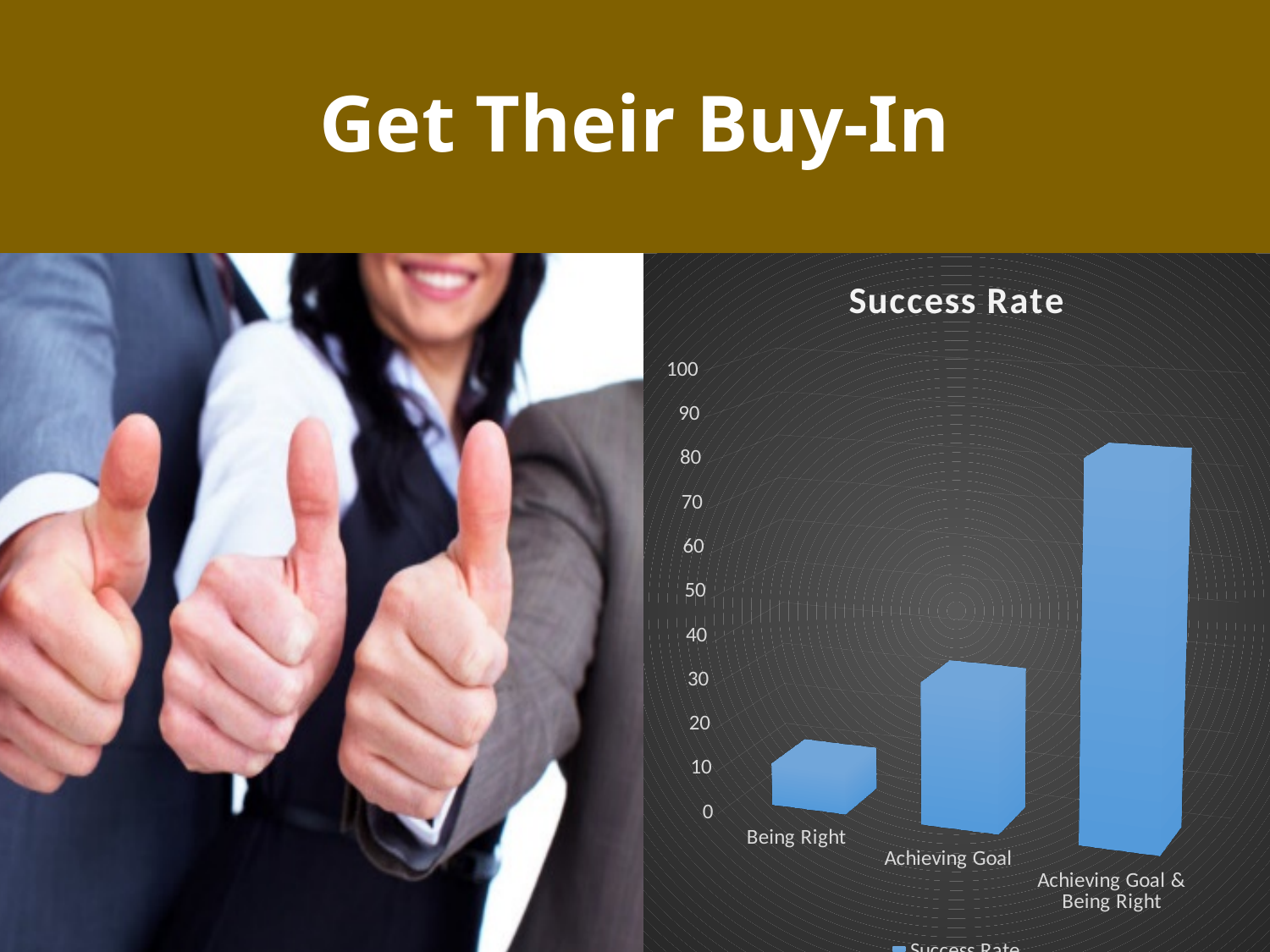
Is the value for Achieving Goal & Being Right greater or less than 60? greater Is the value for Achieving Goal greater or less than 20? greater Is the value for Achieving Goal & Being Right greater or less than 90? less Which category has the highest value in the chart? Achieving Goal & Being Right Which category has the lowest value in the chart? Being Right Which is larger, the value for Achieving Goal or the value for Being Right? Achieving Goal Do the values rise or fall moving from left to right along the x axis? rise How many categories are shown on the x axis of the chart? 3 What type of chart is shown on the slide? bar chart What is the title of the chart? Success Rate